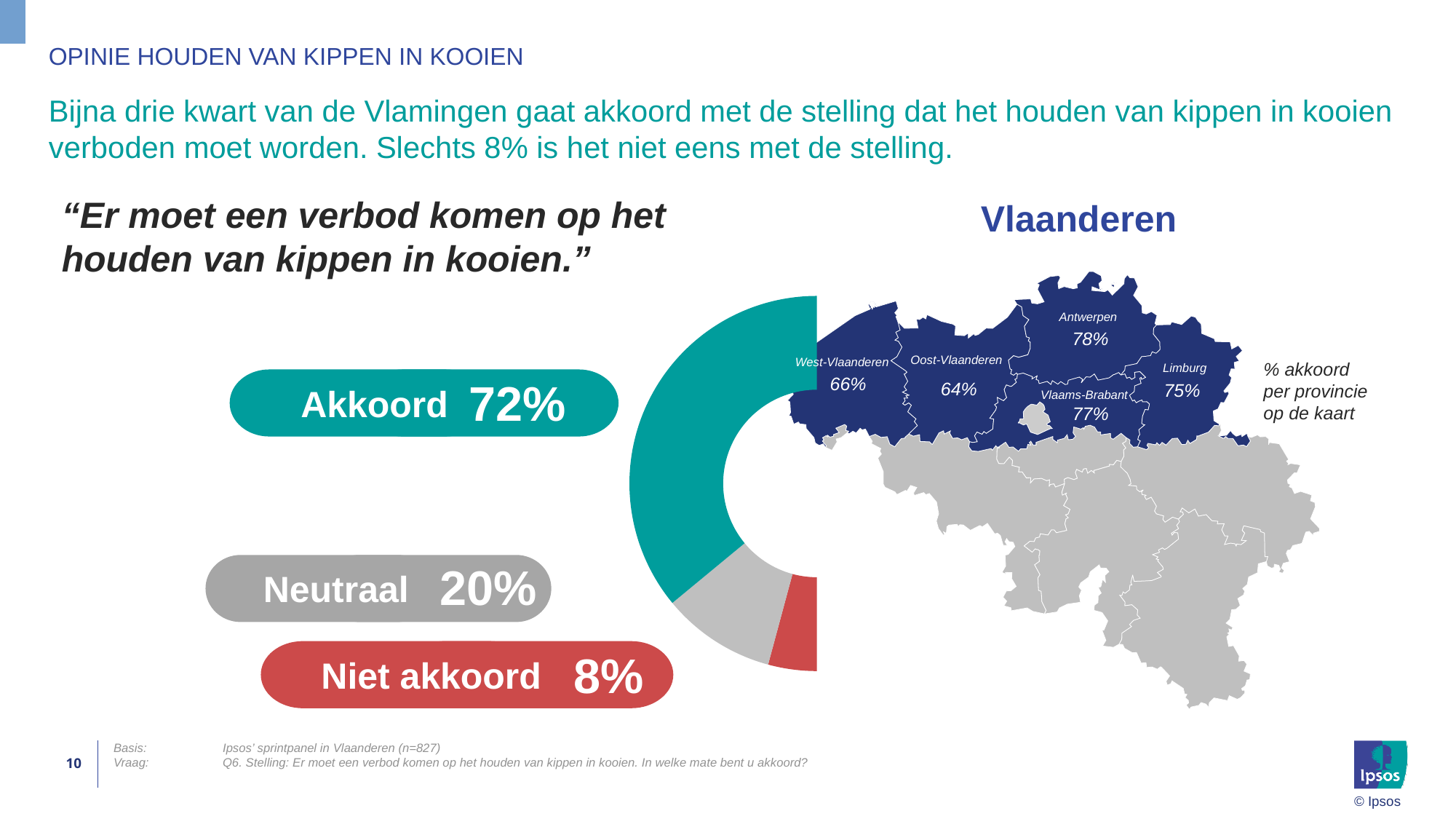
What kind of chart is shown on the left of the slide? Donut chart On the map titled 'Vlaanderen', which has a higher percentage of agreement, Limburg or West-Vlaanderen? Limburg In the donut chart on the left, what percentage of respondents answered 'Neutraal'? 20% In the donut chart on the left, what is the difference in percentage points between 'Akkoord' and 'Neutraal'? 52 On the map titled 'Vlaanderen', what is the percentage of agreement for Antwerpen? 78% On the map titled 'Vlaanderen', which province has the lowest percentage of agreement? Oost-Vlaanderen In the donut chart on the left, what percentage of respondents answered 'Akkoord'? 72% In the donut chart on the left, how many response categories are shown? 3 In the donut chart on the left, what percentage of respondents answered 'Niet akkoord'? 8% In the donut chart on the left, which response category has the smallest share? Niet akkoord On the map titled 'Vlaanderen', which province has the highest percentage of agreement? Antwerpen In the donut chart on the left, which response category has the largest share? Akkoord